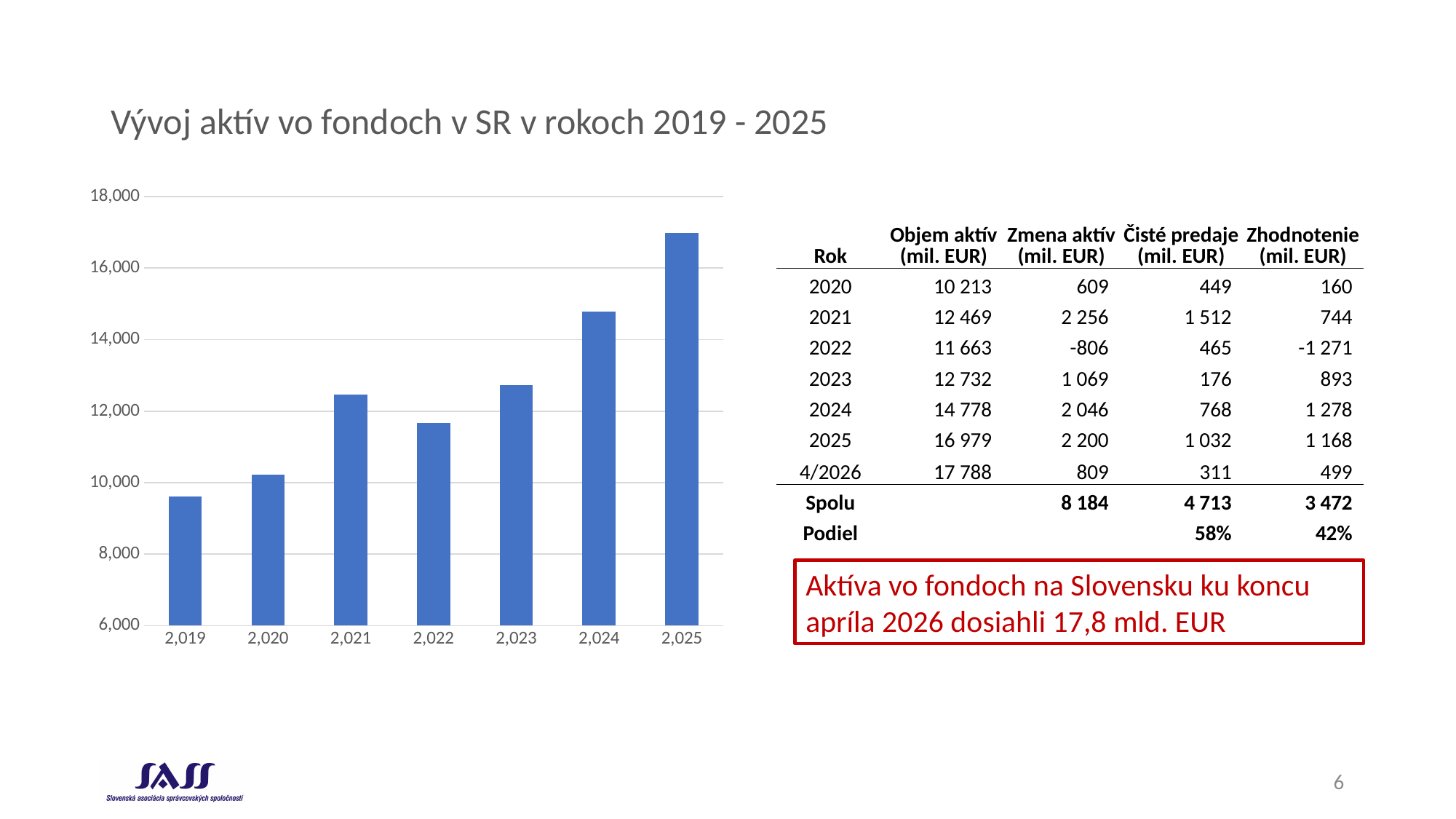
Do the values generally rise or fall from 2019 to 2025? rise Is the value for 2024 greater or less than 14,000? greater Which year has the lowest bar in the chart? 2019 What kind of chart is shown on the slide? bar chart What is the title of the slide chart? Vývoj aktív vo fondoch v SR v rokoch 2019 - 2025 Is the value for 2020 greater or less than 10,000? greater Is the value for 2025 greater or less than 16,000? greater Which bar is taller, 2021 or 2022? 2021 How many years (bars) are plotted in the chart? 7 Which year has the highest bar in the chart? 2025